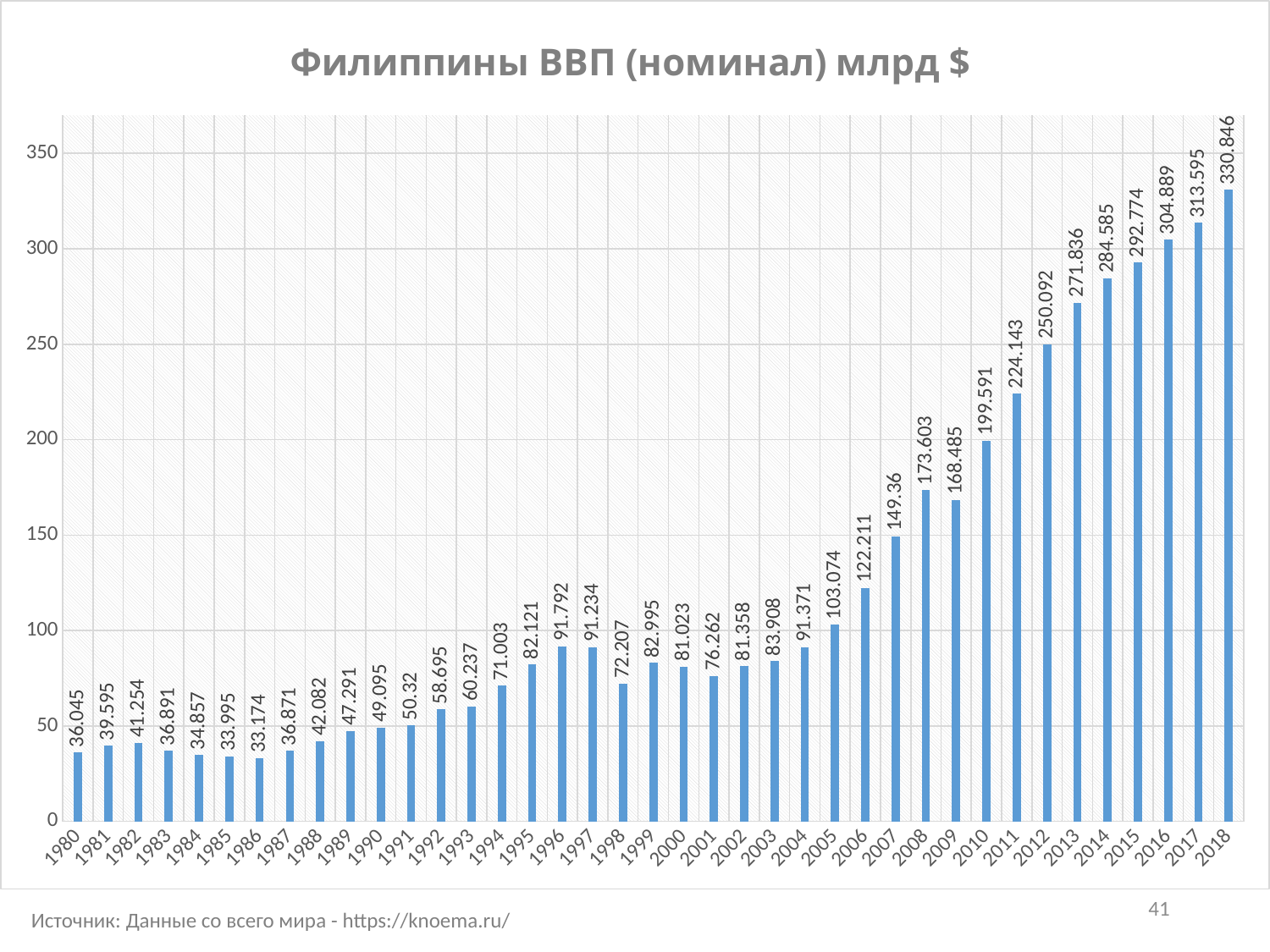
What type of chart is shown on the slide? Bar chart How many years are shown on the x axis? 39 What is the value for 2007? 149.36 Which is larger, the value for 2005 or the value for 2004? 2005 Is the value for 2009 greater or less than 200? less Which year has the lowest value? 1986 What is the title of the chart? Филиппины ВВП (номинал) млрд $ What is the value for 1980? 36.045 Which year has the highest value? 2018 What is the value for 2018? 330.846 What is the difference between the values for 2018 and 2017? 17.251 Do the values generally rise or fall from 1980 to 2018? Rise